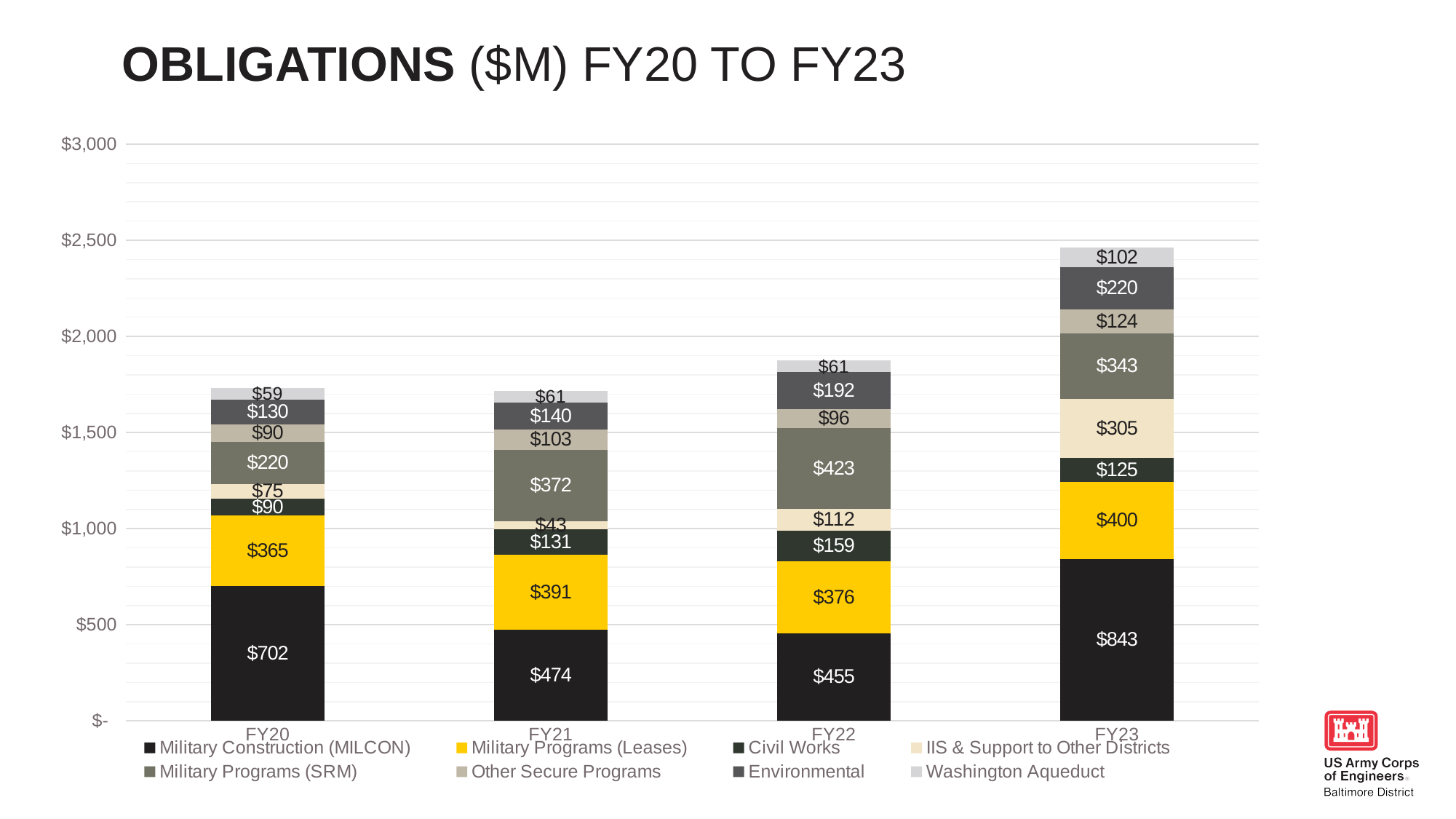
Is the total of the FY22 stacked bar greater or less than $2,000? less What is the total of the FY23 stacked bar? $2,462 What is the difference between the Environmental values for FY23 and FY20? $90 What is the Military Programs (SRM) value for FY22? $423 What type of chart is shown on the slide? Stacked bar chart Which fiscal year has the highest Military Construction (MILCON) value? FY23 Which is larger, the Military Programs (Leases) value for FY21 or for FY22? FY21 What is the IIS & Support to Other Districts value for FY21? $43 How many series does the legend list? 8 What is the Military Construction (MILCON) value for FY23? $843 Which fiscal year has the lowest Washington Aqueduct value? FY20 How many fiscal years are shown on the x axis? 4